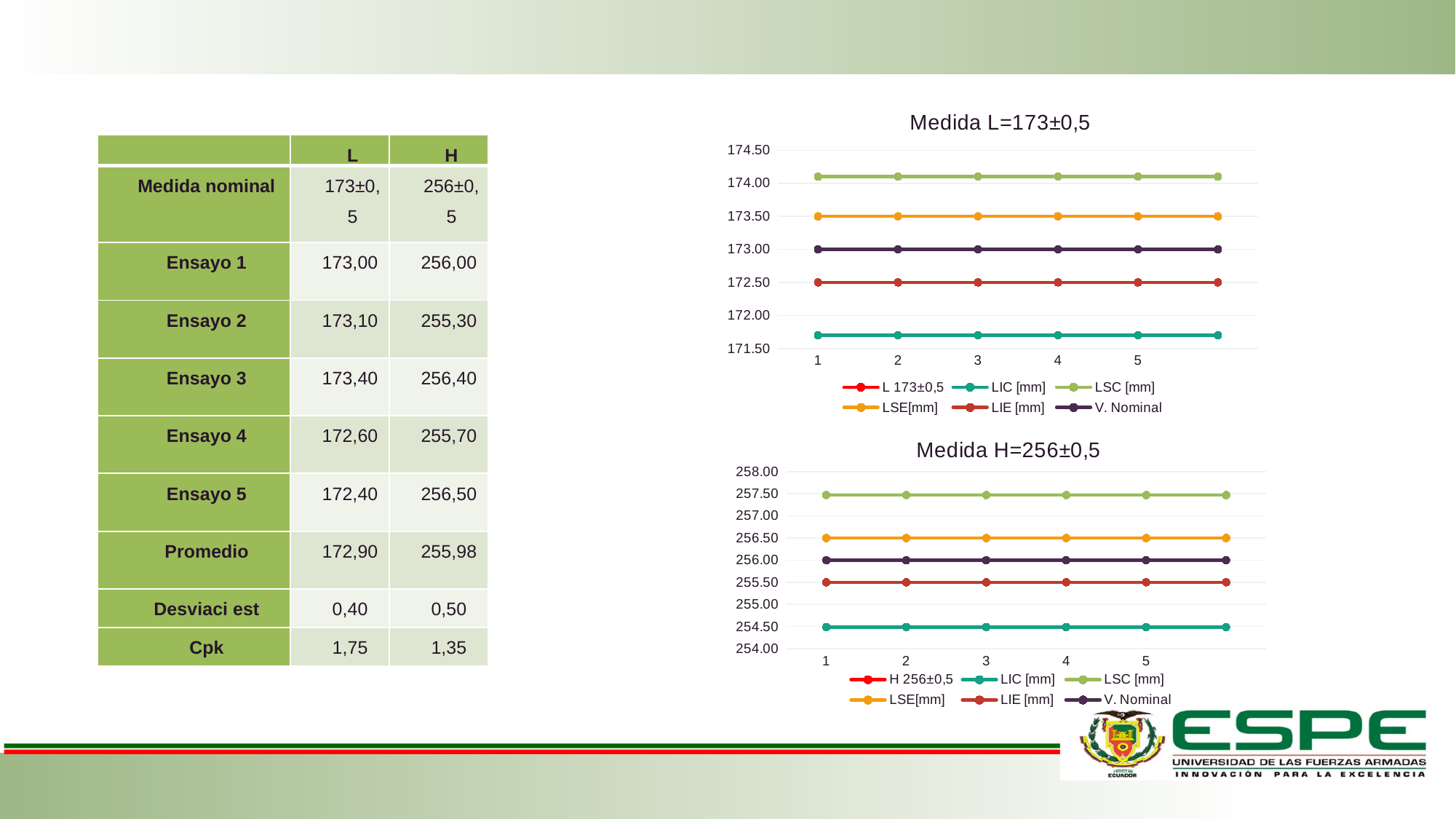
In the 'Medida L=173±0,5' chart, what value does the V. Nominal line sit at? 173.00 What is the title of the lower chart on the slide? Medida H=256±0,5 In the 'Medida H=256±0,5' chart, do the values of the LSE[mm] line rise, fall or stay flat along the x axis? stay flat In the 'Medida L=173±0,5' chart, is the value of the LIC [mm] line greater or less than 172.00? less In the 'Medida L=173±0,5' chart, what value does the LSE[mm] line sit at? 173.50 How many series does the legend of the 'Medida H=256±0,5' chart list? 6 In the 'Medida H=256±0,5' chart, which series has the highest values, LSC [mm] or LIE [mm]? LSC [mm] In the 'Medida H=256±0,5' chart, what value does the V. Nominal line sit at? 256.00 In the 'Medida L=173±0,5' chart, what value does the LIE [mm] line sit at? 172.50 What kind of chart is the 'Medida L=173±0,5' chart? line chart In the 'Medida L=173±0,5' chart, is the value of the LSC [mm] line greater or less than 174.00? greater